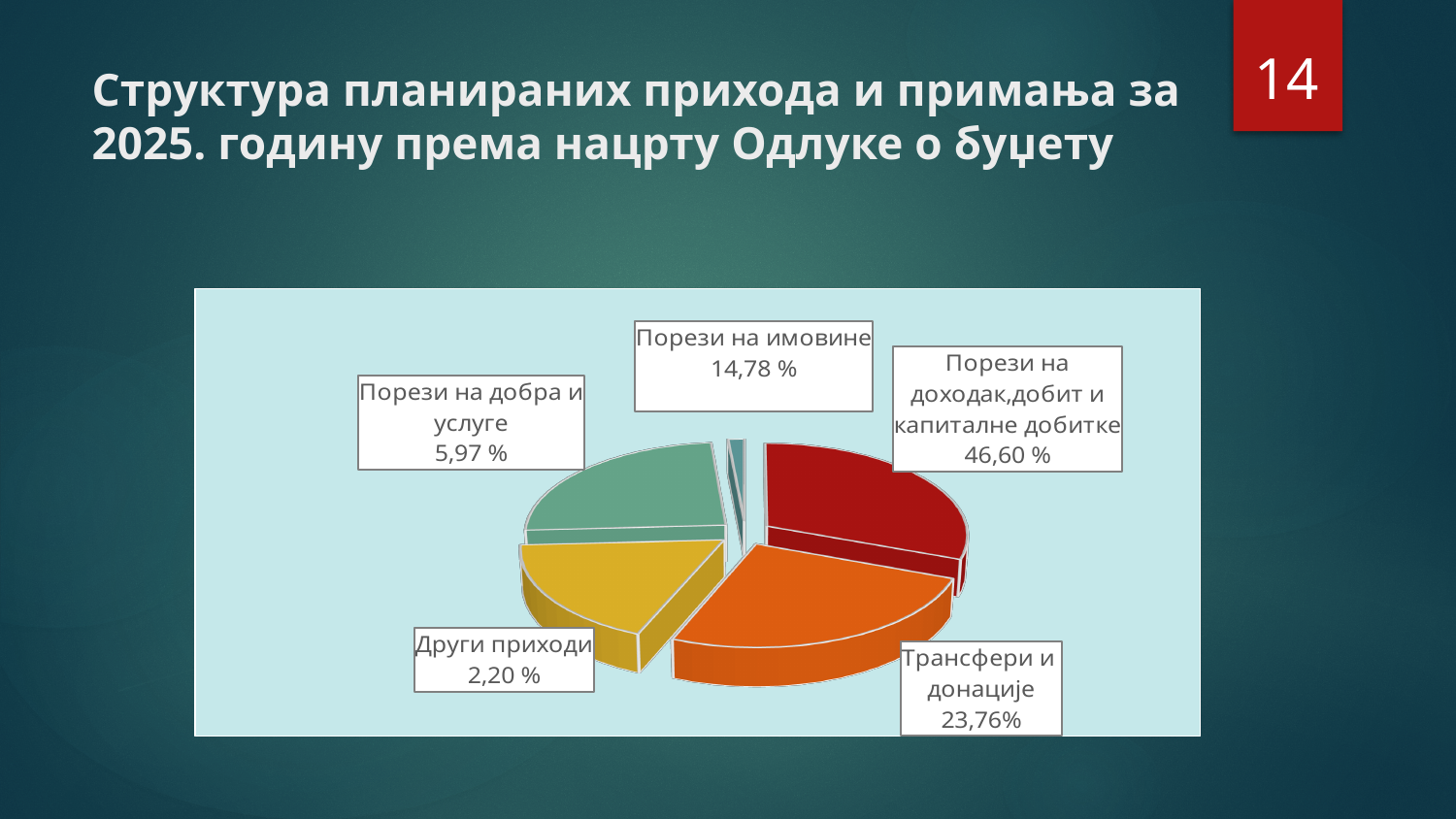
Which labelled category has the largest share of the pie? Порези на доходак,добит и капиталне добитке What share of the pie is labelled for Порези на доходак,добит и капиталне добитке? 46,60 % What is the difference in percentage points between Порези на доходак,добит и капиталне добитке and Трансфери и донације? 22,84 What is the title of the slide containing the chart? Структура планираних прихода и примања за 2025. годину према нацрту Одлуке о буџету What is the difference in percentage points between Порези на добра и услуге and Други приходи? 3,77 Which labelled category has the smallest share of the pie? Други приходи What value is shown for Други приходи? 2,20 % Which is larger, Порези на имовине or Трансфери и донације? Трансфери и донације What value is shown for Трансфери и донације? 23,76% What kind of chart is shown on the slide? Pie chart What value is shown for Порези на добра и услуге? 5,97 % What value is shown for Порези на имовине? 14,78 %